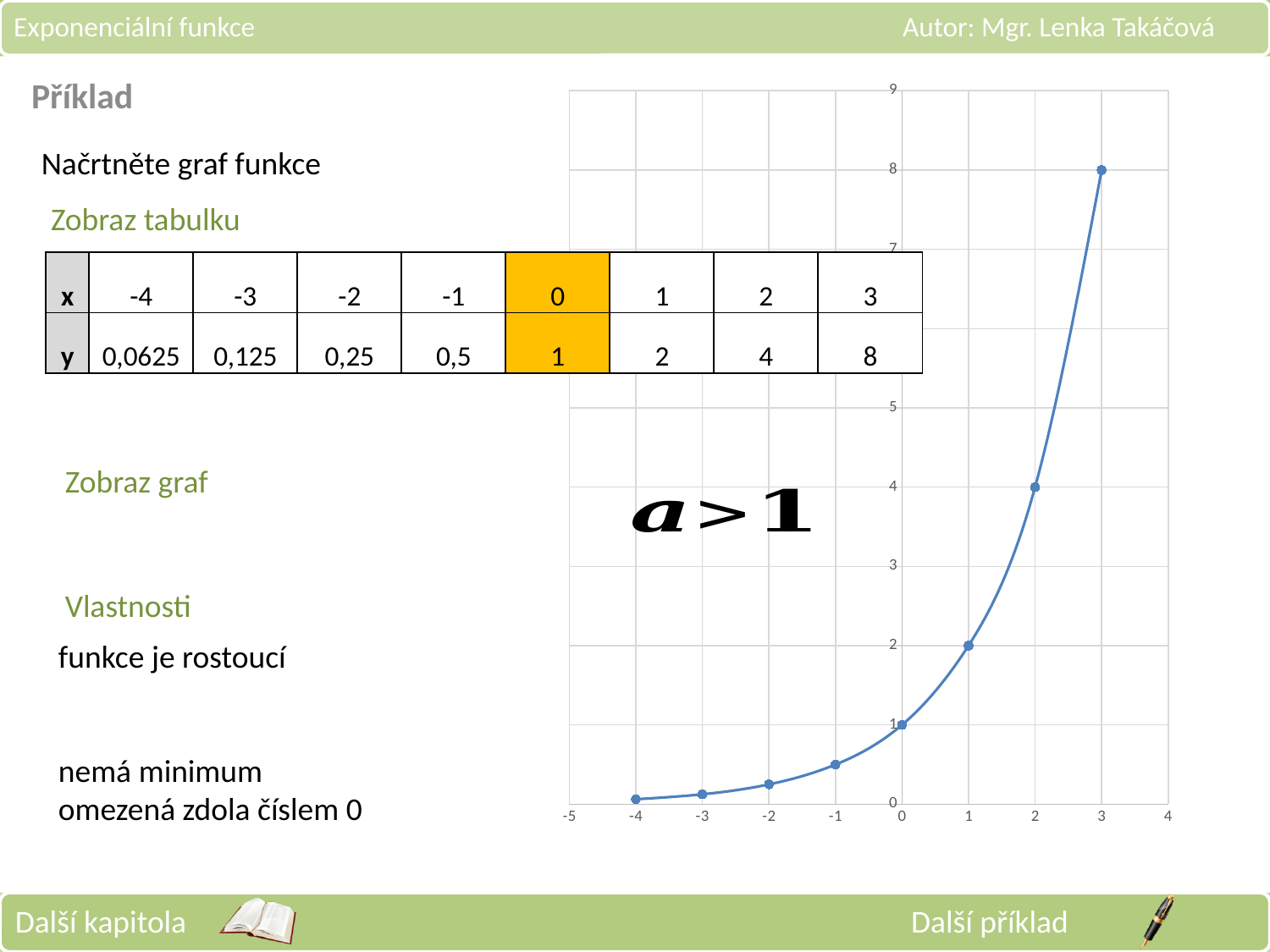
What kind of chart is shown on the slide? line chart At which x value does the chart have its lowest y value? -4 What is the highest value shown on the chart's y axis? 9 Is the y value of the point at x = -1 greater or less than 1? less At which x value does the chart reach its highest y value? 3 What is the y value of the plotted point at x = 0? 1 What is the y value of the plotted point at x = 3? 8 Do the plotted values rise or fall as x increases along the x axis? rise Which point has the larger y value, the one at x = 1 or the one at x = 2? x = 2 What is the difference between the y values at x = 3 and x = 2? 4 How many data points are plotted on the chart? 8 What is the y value of the plotted point at x = 2? 4